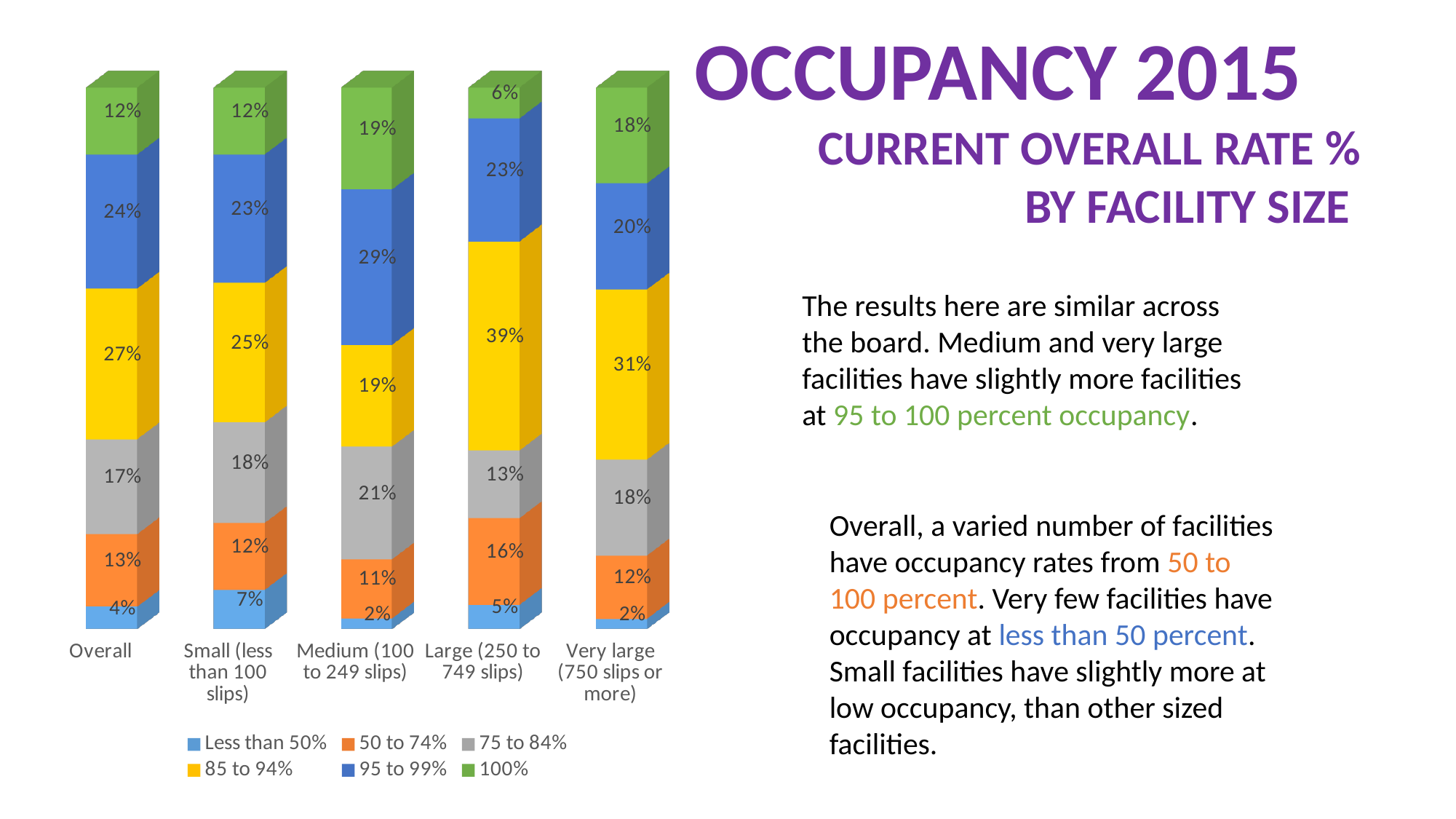
Which is larger, the 50 to 74% value for Large (250 to 749 slips) or for Medium (100 to 249 slips)? Large (250 to 749 slips) Which category has the lowest value for the 100% series? Large (250 to 749 slips) What kind of chart is shown on the slide? Stacked bar chart Which colour represents the 100% series in the legend? Green What is the difference between the 85 to 94% values for Large (250 to 749 slips) and Overall? 12% Which category has the highest value for the 100% series? Medium (100 to 249 slips) How many facility size categories are plotted on the chart? 5 What is the value of the 85 to 94% segment for Large (250 to 749 slips)? 39% What is the total of the 75 to 84% and 85 to 94% segments for Very large (750 slips or more)? 49% What is the value of the 95 to 99% segment for Medium (100 to 249 slips)? 29% What is the value of the Less than 50% segment for Small (less than 100 slips)? 7% How many series does the chart legend list? 6